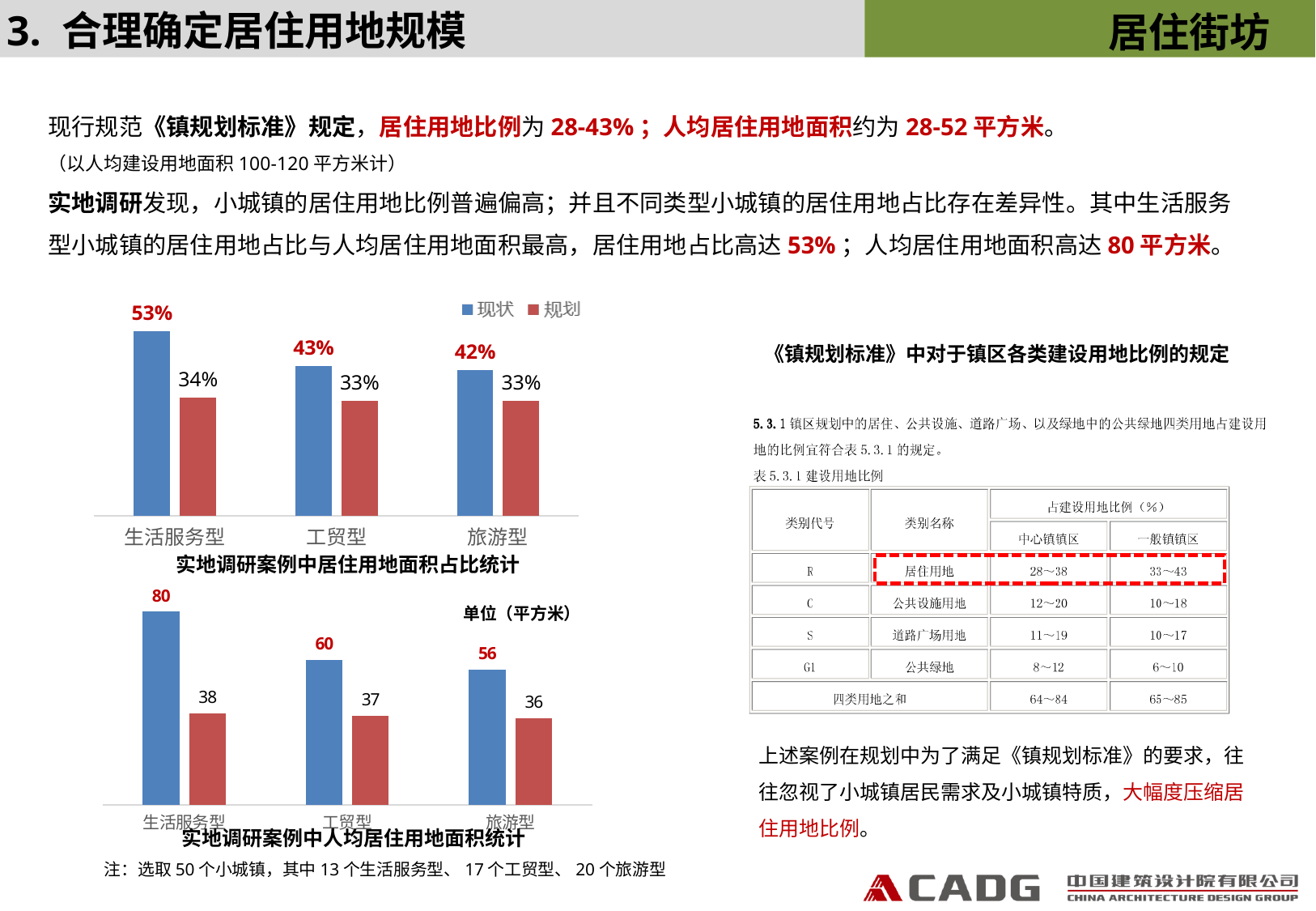
In the chart titled 实地调研案例中人均居住用地面积统计, what is the value of the red bar for 旅游型? 36 In the chart titled 实地调研案例中人均居住用地面积统计, what is the value of the blue bar for 生活服务型? 80 In the chart titled 实地调研案例中人均居住用地面积统计, which category has the lowest blue-bar value? 旅游型 In the chart titled 实地调研案例中居住用地面积占比统计, how many series does the legend list? 2 In the chart titled 实地调研案例中人均居住用地面积统计, how many categories are shown on the x axis? 3 In the chart titled 实地调研案例中人均居住用地面积统计, what unit is stated for the values? 平方米 In the chart titled 实地调研案例中居住用地面积占比统计, what is the difference between the 现状 and 规划 values for 生活服务型? 19% In the chart titled 实地调研案例中人均居住用地面积统计, what is the difference between the blue and red bars for 工贸型? 23 In the chart titled 实地调研案例中居住用地面积占比统计, what is the 规划 value for 工贸型? 33% In the chart titled 实地调研案例中居住用地面积占比统计, which category has the highest 现状 value? 生活服务型 In the chart titled 实地调研案例中居住用地面积占比统计, what is the 现状 value for 生活服务型? 53% In the chart titled 实地调研案例中居住用地面积占比统计, what kind of chart is it? Bar chart